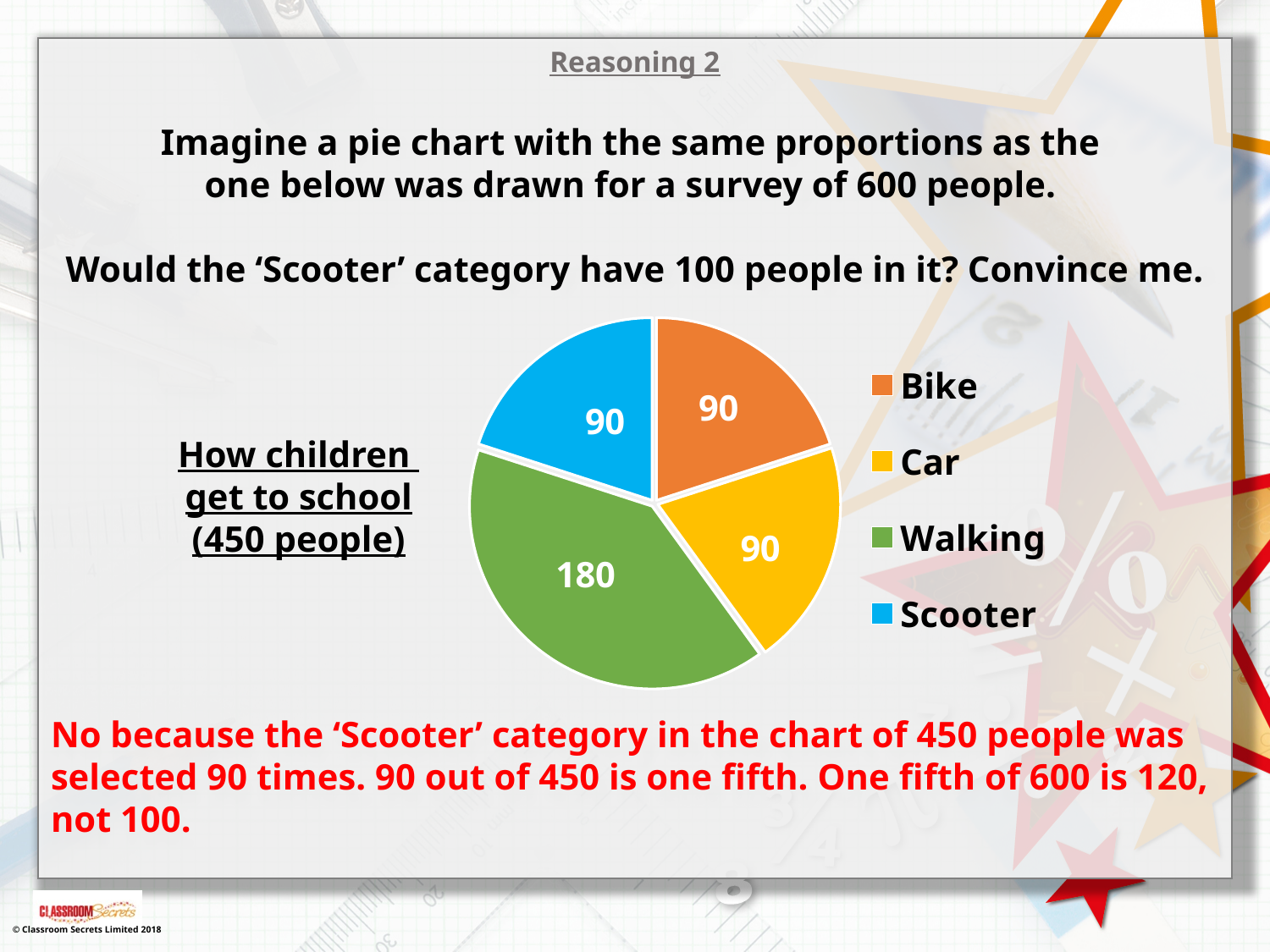
What kind of chart is shown on the slide? pie chart What is the value for Scooter in the pie chart? 90 Which category has the largest slice of the pie chart? Walking Which is larger, the value for Walking or the value for Bike? Walking What is the difference between the values for Walking and Car? 90 What share of the pie chart does Walking represent? 40% What colour is the Scooter slice in the pie chart? blue What is the value for Bike in the pie chart? 90 What is the total of all the slices in the pie chart? 450 What is the value for Walking in the pie chart? 180 What share of the pie chart does Scooter represent? 20% How many categories does the pie chart show? 4